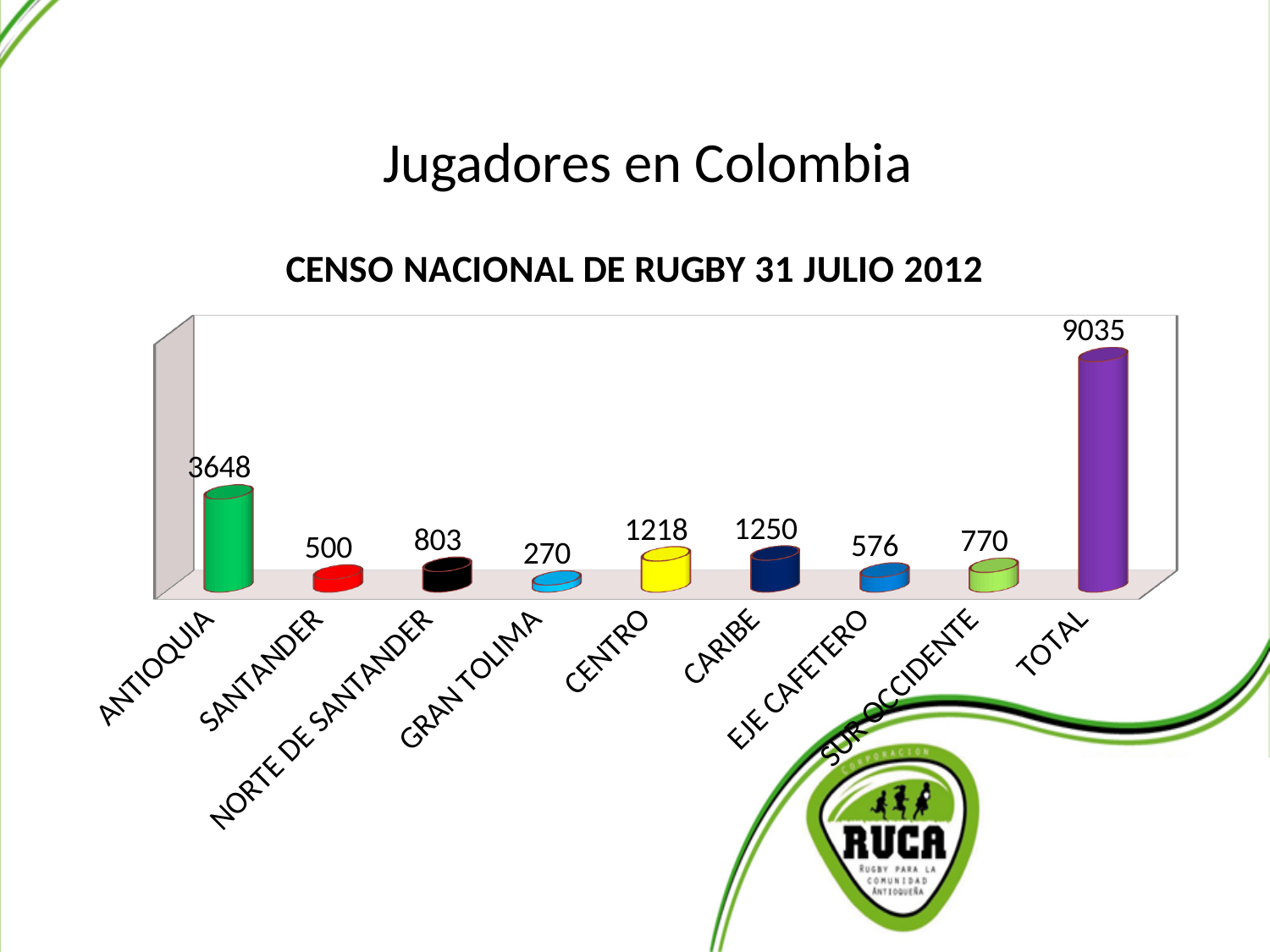
What is the value for CARIBE? 1250 What is the difference between the values for ANTIOQUIA and SANTANDER? 3148 Which category has the highest value? TOTAL What colour is the bar for CENTRO? yellow What is the value for GRAN TOLIMA? 270 What kind of chart is shown on the slide? bar chart Which is larger, the value for NORTE DE SANTANDER or the value for EJE CAFETERO? NORTE DE SANTANDER What is the value for SUR OCCIDENTE? 770 What is the value for ANTIOQUIA? 3648 Which category has the lowest value? GRAN TOLIMA How many categories are shown on the x axis? 9 What is the title of the chart? CENSO NACIONAL DE RUGBY 31 JULIO 2012